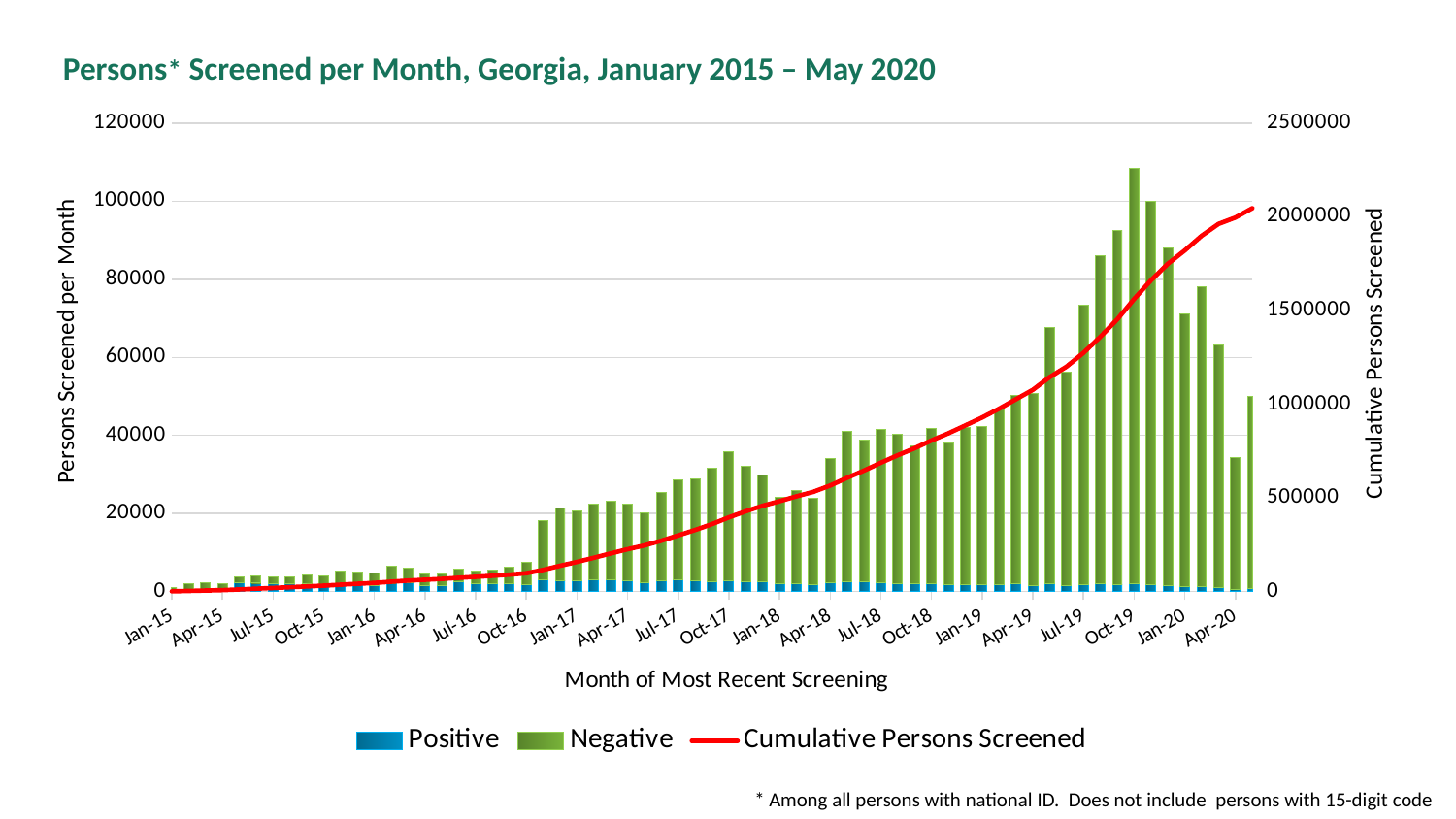
Does the Cumulative Persons Screened line rise or fall from Jan-15 to Apr-20? rise Is the total number of persons screened in Apr-20 greater or less than 40000? less Which month has the highest number of persons screened per month? Oct-19 Is the cumulative number of persons screened in Jan-17 greater or less than 500000? less Which month has more persons screened, Oct-19 or Apr-20? Oct-19 How many series does the legend list? 3 What is the title of the chart? Persons* Screened per Month, Georgia, January 2015 – May 2020 Do the monthly bars rise or fall from Oct-19 to Apr-20? fall Is the total number of persons screened in Jan-20 greater or less than 80000? less What kind of chart is shown on the slide? Bar chart with a line